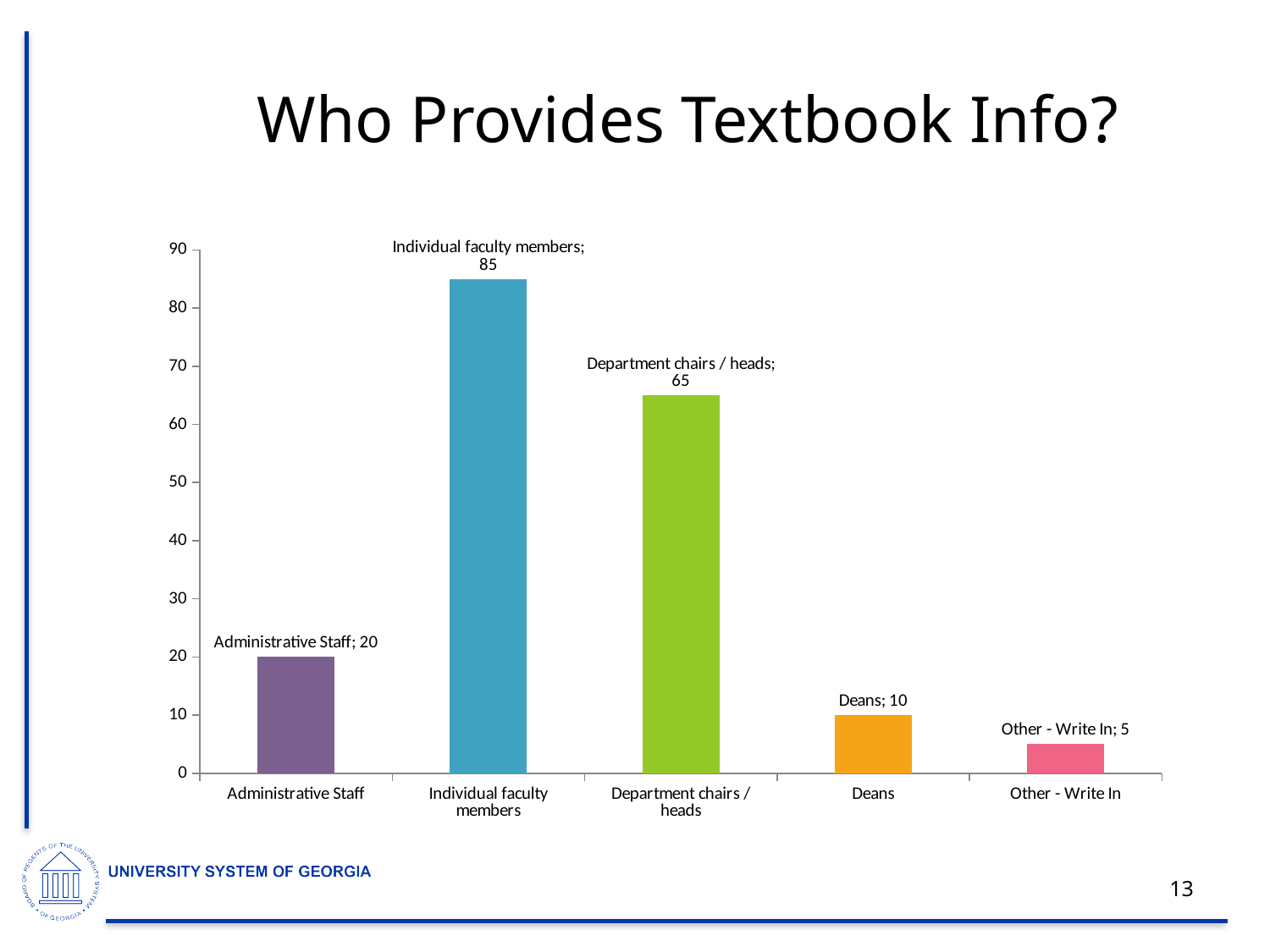
What is the difference between the values for Individual faculty members and Department chairs / heads? 20 What is the value for Administrative Staff? 20 Which is larger, the value for Administrative Staff or the value for Deans? Administrative Staff What is the value for Deans? 10 What kind of chart is shown on the slide? Bar chart Which category has the highest value? Individual faculty members What is the value for Department chairs / heads? 65 Is the value for Department chairs / heads greater or less than 60? greater What is the title of the slide containing the chart? Who Provides Textbook Info? What is the value for Individual faculty members? 85 Which category has the lowest value? Other - Write In How many categories are shown on the chart? 5